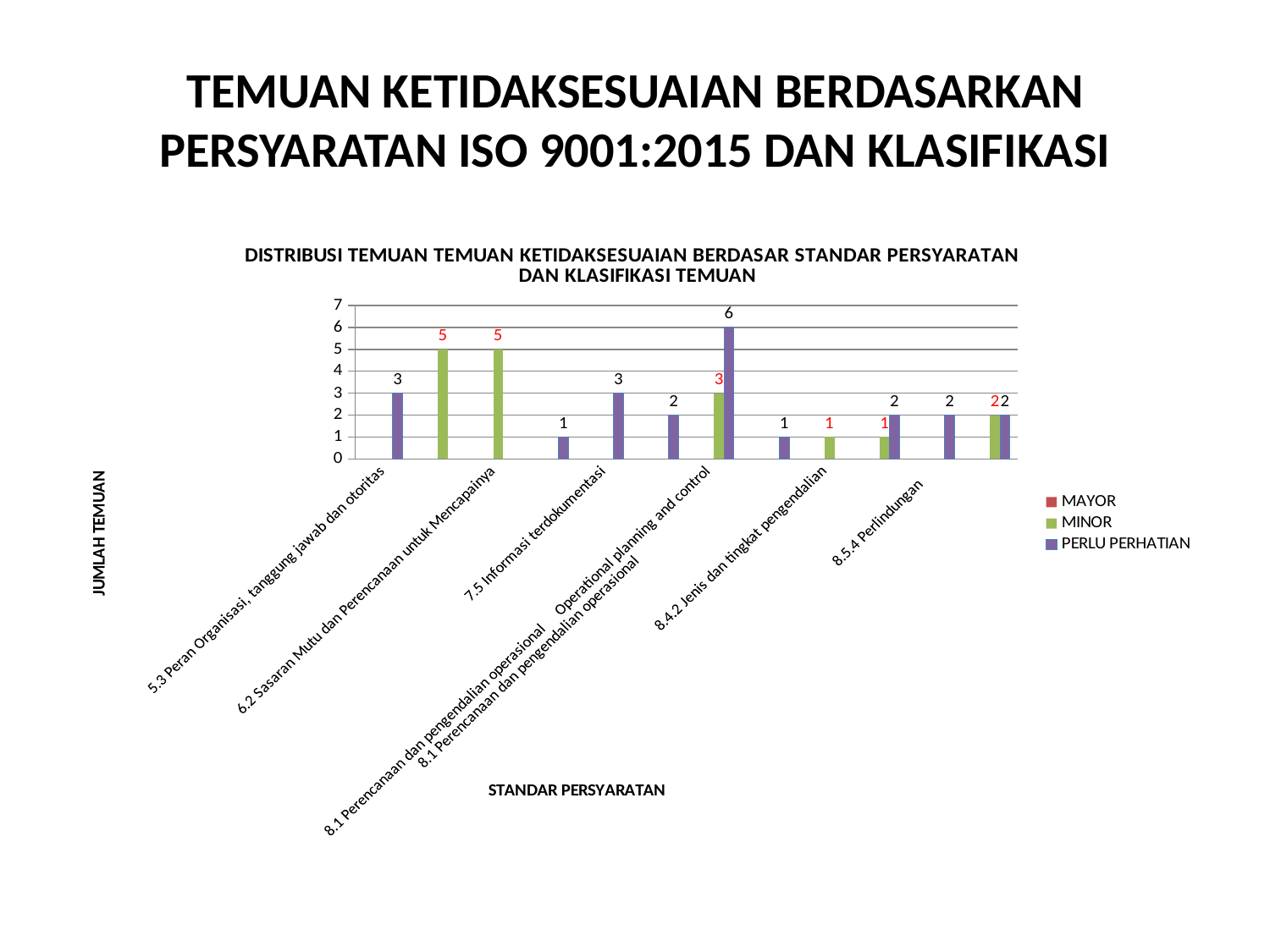
What is the title of the vertical axis of the chart? JUMLAH TEMUAN What are the three series listed in the legend? MAYOR, MINOR, PERLU PERHATIAN What is the difference between the MINOR value for '6.2 Sasaran Mutu dan Perencanaan untuk Mencapainya' and the PERLU PERHATIAN value for '7.5 Informasi terdokumentasi'? 2 What is the highest value shown by any bar in the chart? 6 Which is larger: the MINOR value for '6.2 Sasaran Mutu dan Perencanaan untuk Mencapainya' or the PERLU PERHATIAN value for '5.3 Peran Organisasi, tanggung jawab dan otoritas'? 6.2 Sasaran Mutu dan Perencanaan untuk Mencapainya Which series has the tallest bar in the chart? PERLU PERHATIAN What kind of chart is shown on the slide? bar chart What is the PERLU PERHATIAN value for '7.5 Informasi terdokumentasi'? 3 What is the MINOR value for '8.4.2 Jenis dan tingkat pengendalian'? 1 What is the MINOR value for '6.2 Sasaran Mutu dan Perencanaan untuk Mencapainya'? 5 How many series does the legend list? 3 What is the PERLU PERHATIAN value for '5.3 Peran Organisasi, tanggung jawab dan otoritas'? 3